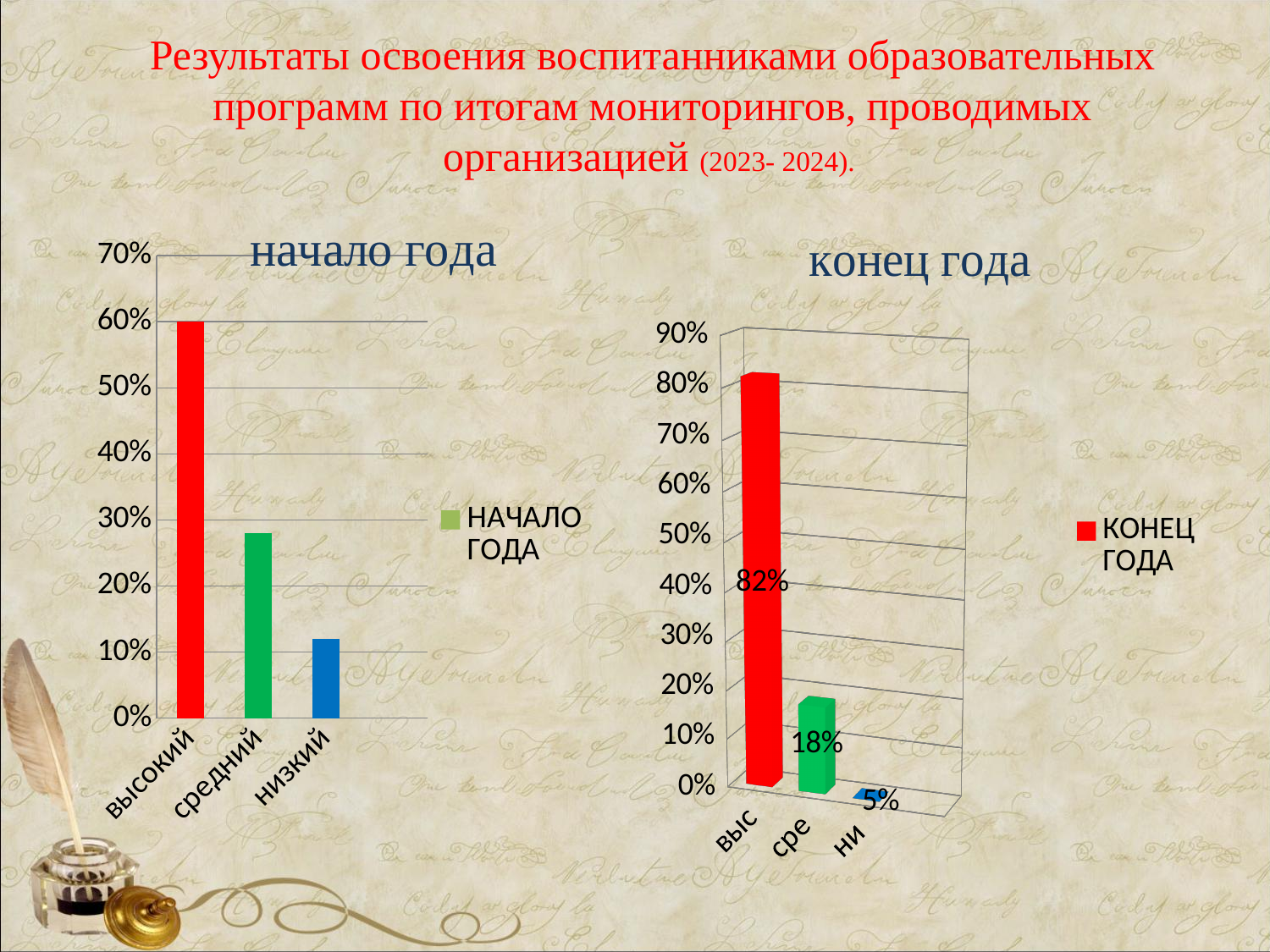
In the "конец года" chart, what is the difference between the values for выс and сре? 64% In the "начало года" chart, which category has the highest value? высокий In the "начало года" chart, is the value for средний greater or less than 30%? less In the "конец года" chart, which is larger, the value for сре or the value for ни? сре In the "конец года" chart, what is the value for сре? 18% In the "начало года" chart, is the value for низкий greater or less than 10%? greater How many categories are shown in the "начало года" chart? 3 What type of chart is the "начало года" chart? bar chart In the "начало года" chart, which category has the lowest value? низкий In the "конец года" chart, what is the value for ни? 5% What legend entry is shown for the "конец года" chart? КОНЕЦ ГОДА In the "конец года" chart, what is the value for выс? 82%